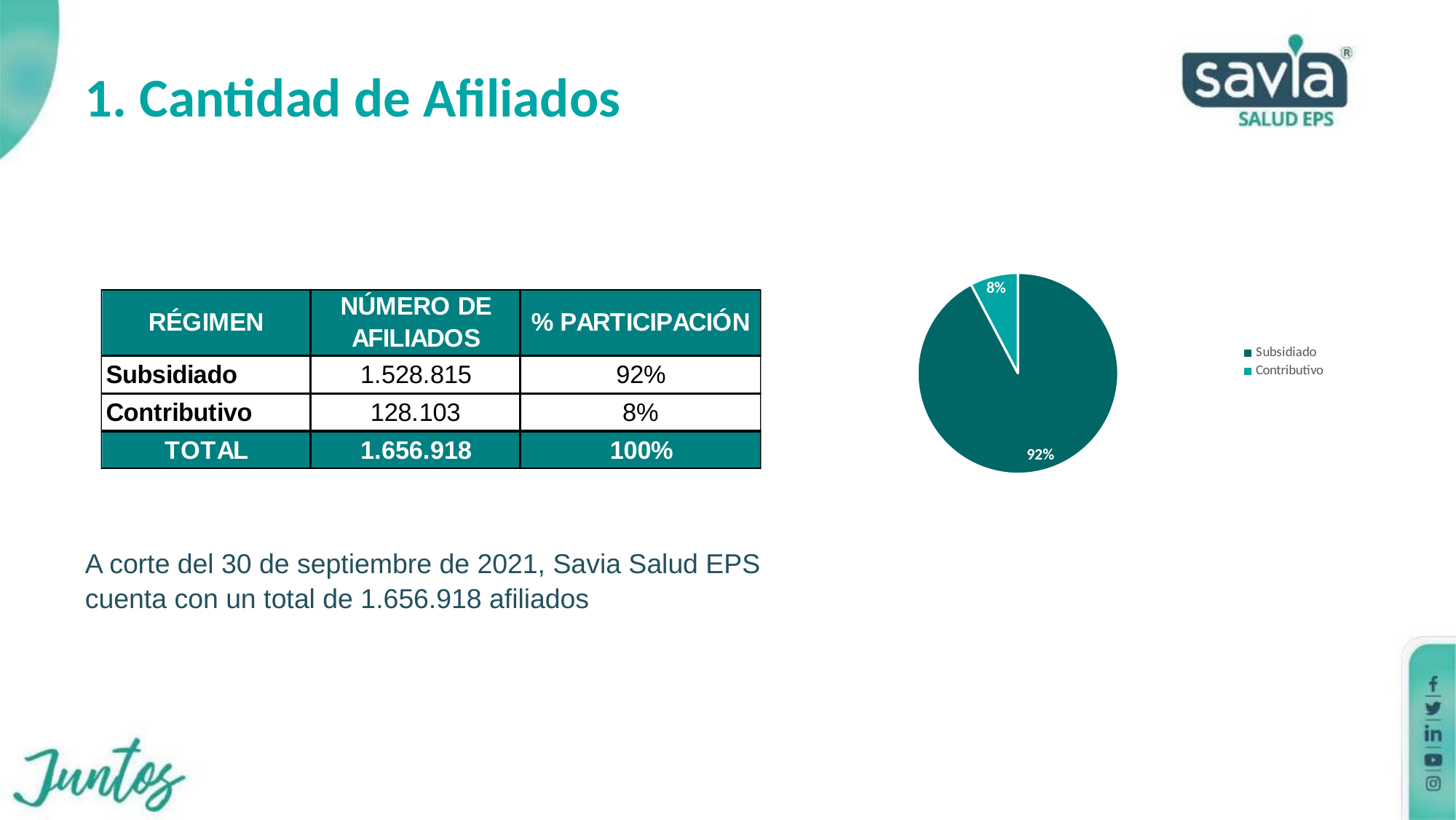
Which category has the smallest slice in the pie chart? Contributivo How many entries does the legend of the pie chart list? 2 What share of the pie chart does Subsidiado represent? 92% What kind of chart is shown on the slide? pie chart Which slice is larger in the pie chart, Subsidiado or Contributivo? Subsidiado What share of the pie chart does Contributivo represent? 8% Where is the legend positioned relative to the pie chart? to the right What is the difference in percentage points between the Subsidiado and Contributivo slices? 84 How many slices does the pie chart have? 2 Which category has the largest slice in the pie chart? Subsidiado Which legend entry is shown in the lighter teal colour? Contributivo